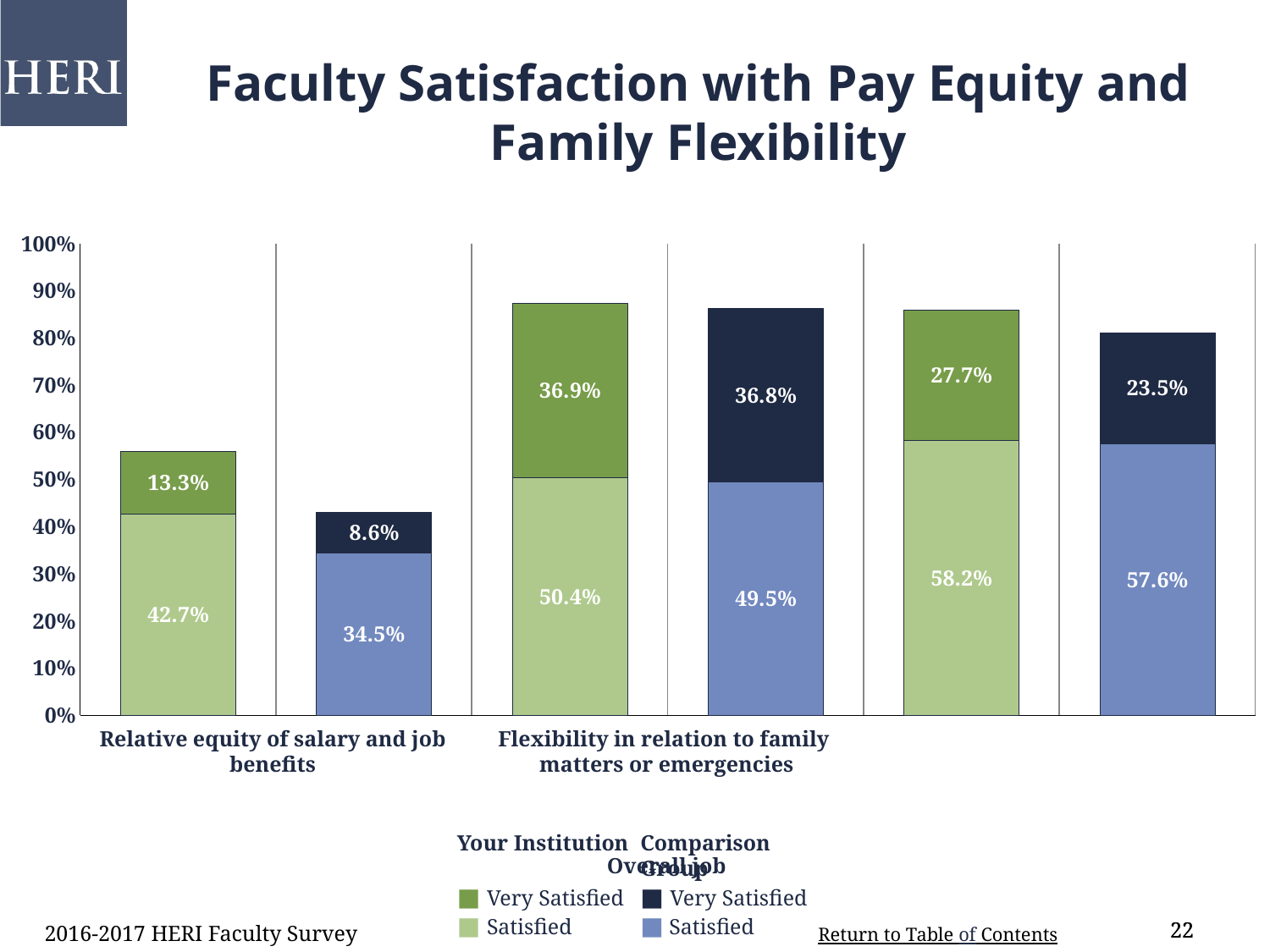
What is the combined percentage of Satisfied and Very Satisfied for Your Institution on relative equity of salary and job benefits? 56.0% How many entries does the legend list? 4 What is the difference between the Satisfied percentages for Your Institution and the Comparison Group on relative equity of salary and job benefits? 8.2% What percentage of the Comparison Group are Satisfied with flexibility in relation to family matters or emergencies? 49.5% Is the total stacked bar for the Comparison Group on relative equity of salary and job benefits greater or less than 50%? less What is the combined percentage of Satisfied and Very Satisfied for the Comparison Group on flexibility in relation to family matters or emergencies? 86.3% What kind of chart is shown on the slide? Stacked bar chart What percentage of the Comparison Group are Very Satisfied with relative equity of salary and job benefits? 8.6% Which has a higher Very Satisfied percentage for relative equity of salary and job benefits: Your Institution or the Comparison Group? Your Institution What percentage of faculty at Your Institution are Very Satisfied with flexibility in relation to family matters or emergencies? 36.9% What percentage of faculty at Your Institution are Satisfied with relative equity of salary and job benefits? 42.7% What colour represents Very Satisfied for the Comparison Group? Dark navy blue